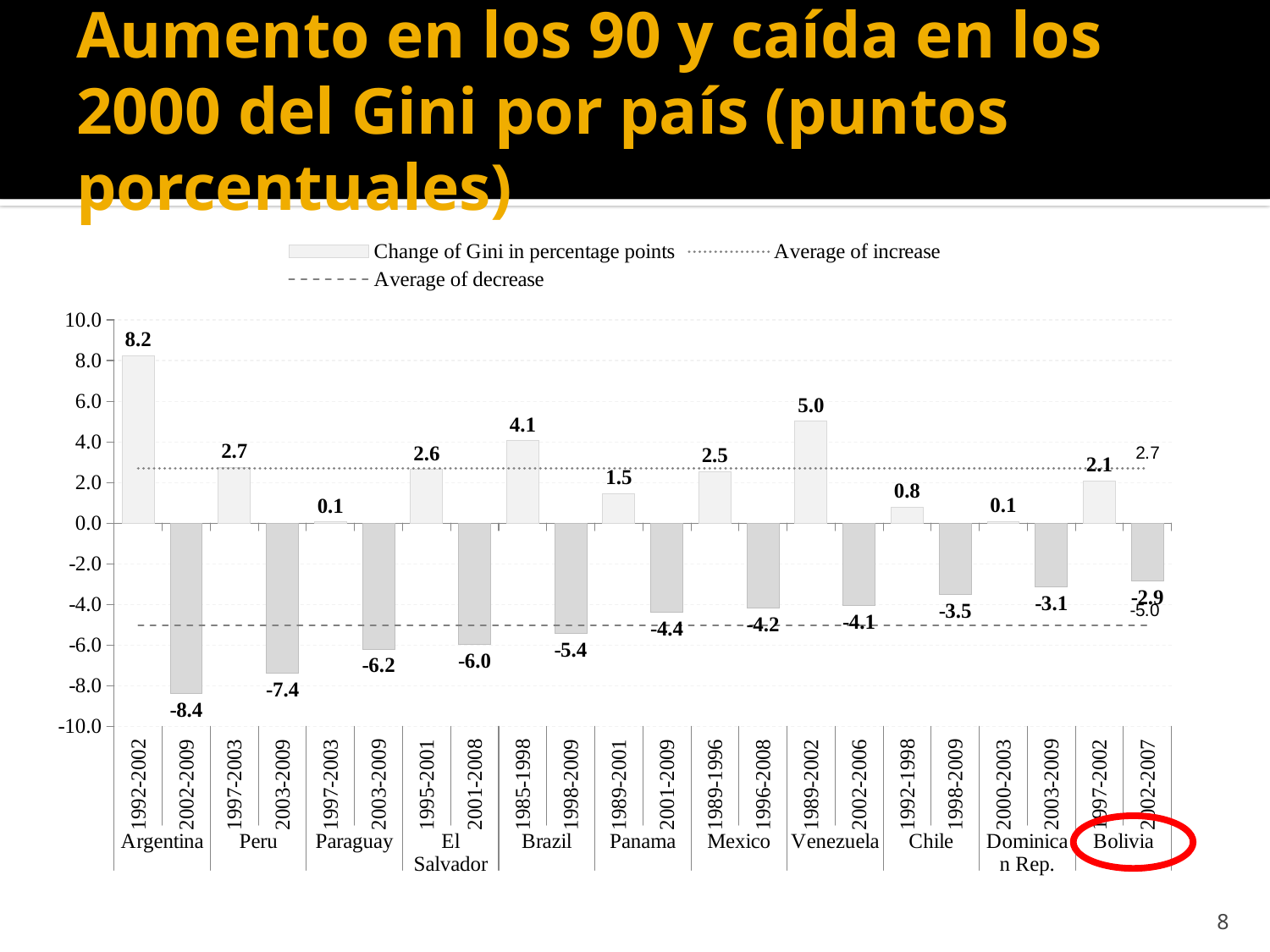
What is the change of Gini in percentage points for Venezuela in 1989-2002? 5.0 What is the difference between the Gini change for Brazil in 1985-1998 and for Peru in 1997-2003? 1.4 Which bar shows the largest decrease in Gini? Argentina 2002-2009 How many entries does the legend list? 3 What kind of chart is shown on the slide? Bar chart What value is shown for the average of decrease line? -5.0 What is the change of Gini in percentage points for Argentina in 1992-2002? 8.2 Which is larger, the Gini change for Mexico in 1989-1996 or for El Salvador in 1995-2001? El Salvador 1995-2001 What is the change of Gini in percentage points for Bolivia in 2002-2007? -2.9 How many countries are shown on the x axis? 11 Which bar shows the largest increase in Gini? Argentina 1992-2002 What value is shown for the average of increase line? 2.7